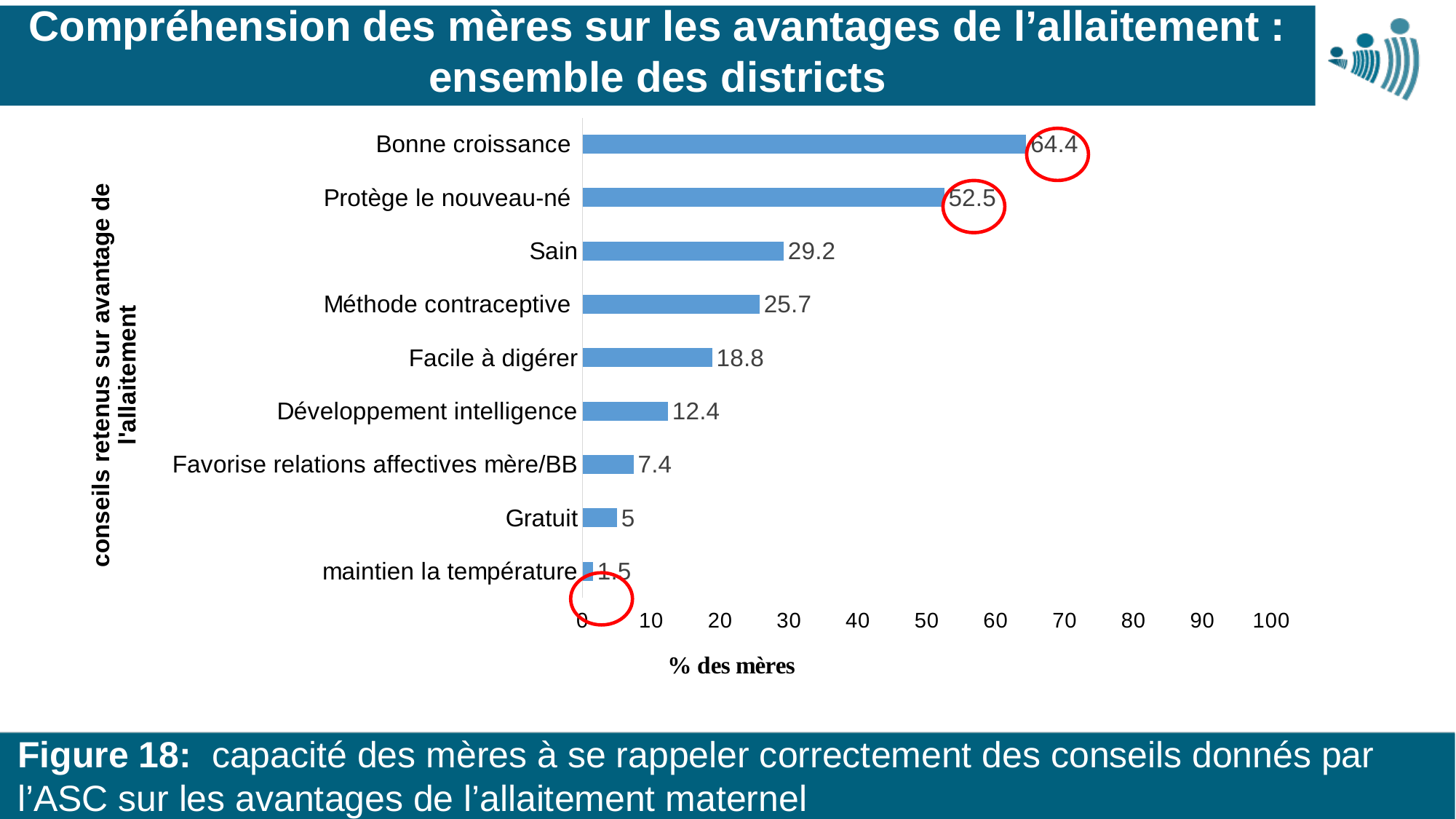
What is the value for Méthode contraceptive? 25.7 What is the difference between the values for Sain and Méthode contraceptive? 3.5 How many categories are shown in the chart? 9 What kind of chart is shown on the slide? Bar chart What is the value for Gratuit? 5 Which is larger, the value for Facile à digérer or the value for Développement intelligence? Facile à digérer Which category has the highest value? Bonne croissance What is the label of the horizontal axis? % des mères What is the difference between the values for Bonne croissance and Protège le nouveau-né? 11.9 What is the value for Bonne croissance? 64.4 What is the value for Protège le nouveau-né? 52.5 Which category has the lowest value? maintien la température